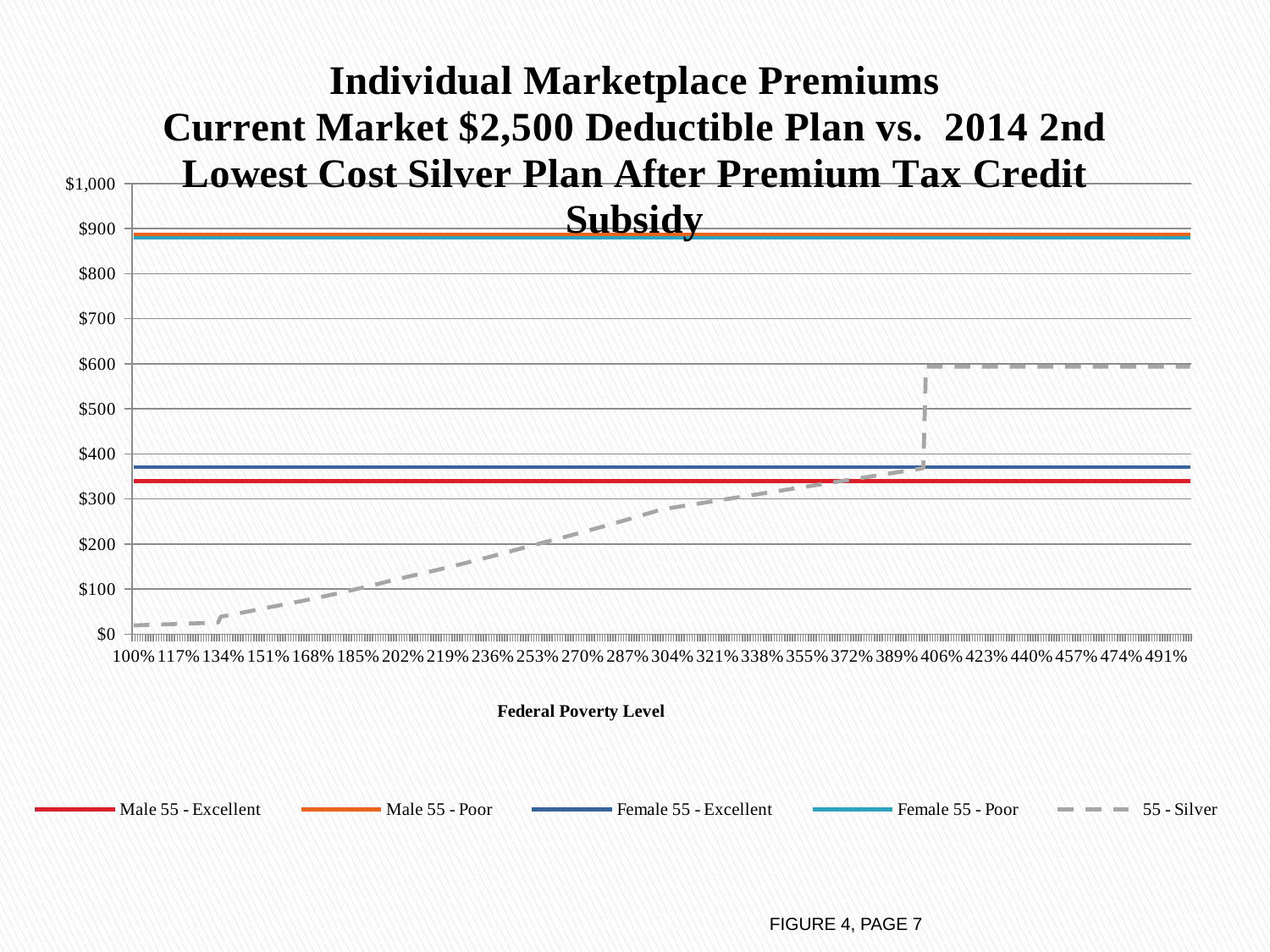
Is the value for Male 55 - Excellent greater or less than $400? less Is the value for Male 55 - Poor greater or less than $800? greater Which series has the lowest value at 100% Federal Poverty Level? 55 - Silver Does the 55 - Silver line rise or fall as the Federal Poverty Level increases along the x axis? Rise Which is larger, the value for Female 55 - Excellent or the value for Male 55 - Excellent? Female 55 - Excellent What kind of chart is shown on the slide? Line chart Which series is drawn as a dashed gray line? 55 - Silver What is the title of the x axis? Federal Poverty Level Is the value for 55 - Silver at 491% Federal Poverty Level greater or less than $500? greater How many series does the legend list? 5